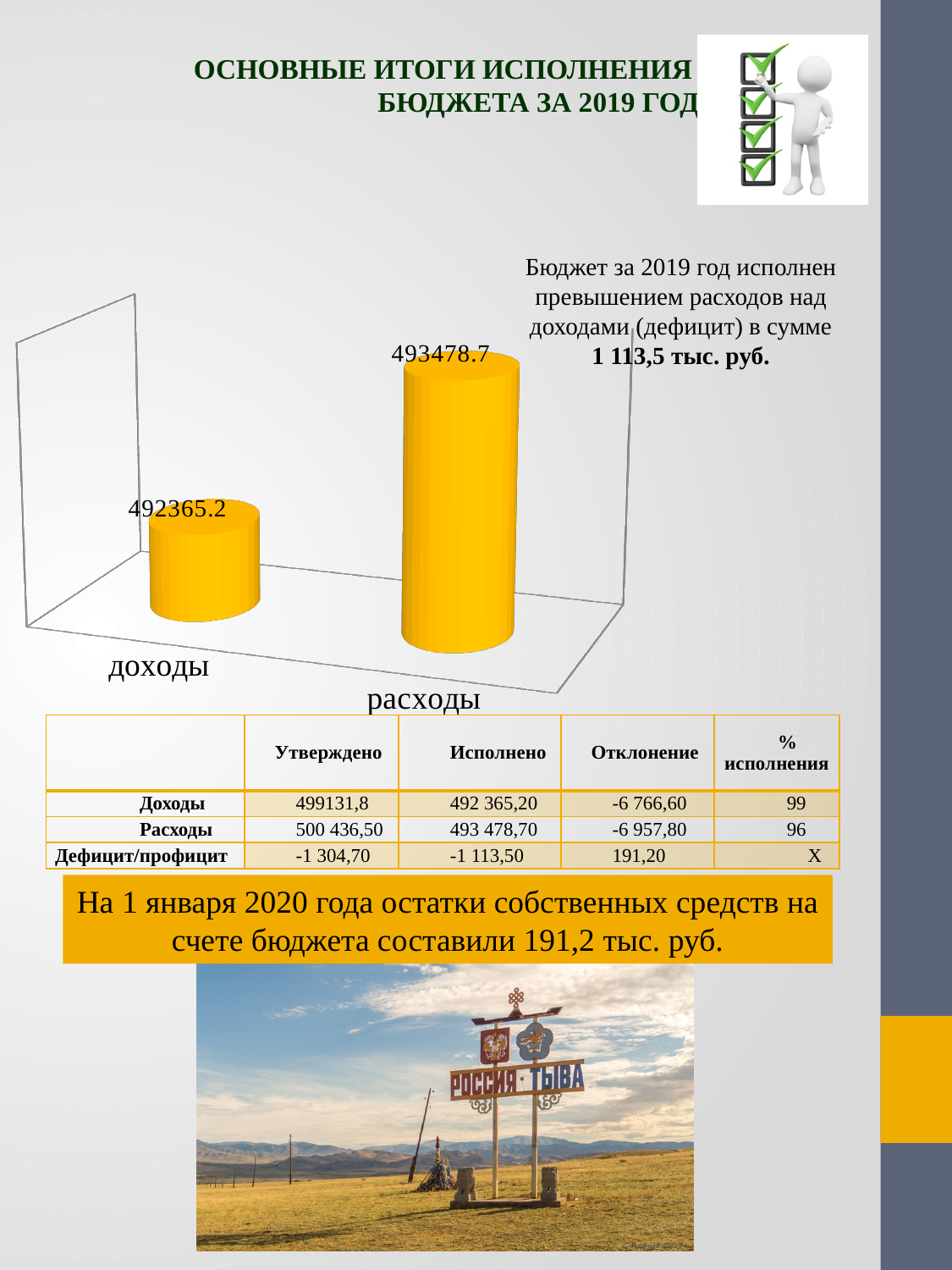
What kind of chart is shown on the slide? bar chart What is the difference between the values for расходы and доходы on the chart? 1113.5 Which category has the lower value on the chart? доходы What is the value shown for расходы on the chart? 493478.7 Do the values rise or fall going from доходы to расходы? rise What colour are the bars on the chart? yellow How many categories are plotted on the chart? 2 Which category has the higher value on the chart? расходы Is the value for расходы larger or smaller than the value for доходы? larger What is the value shown for доходы on the chart? 492365.2 What are the two category labels on the chart's x axis? доходы, расходы